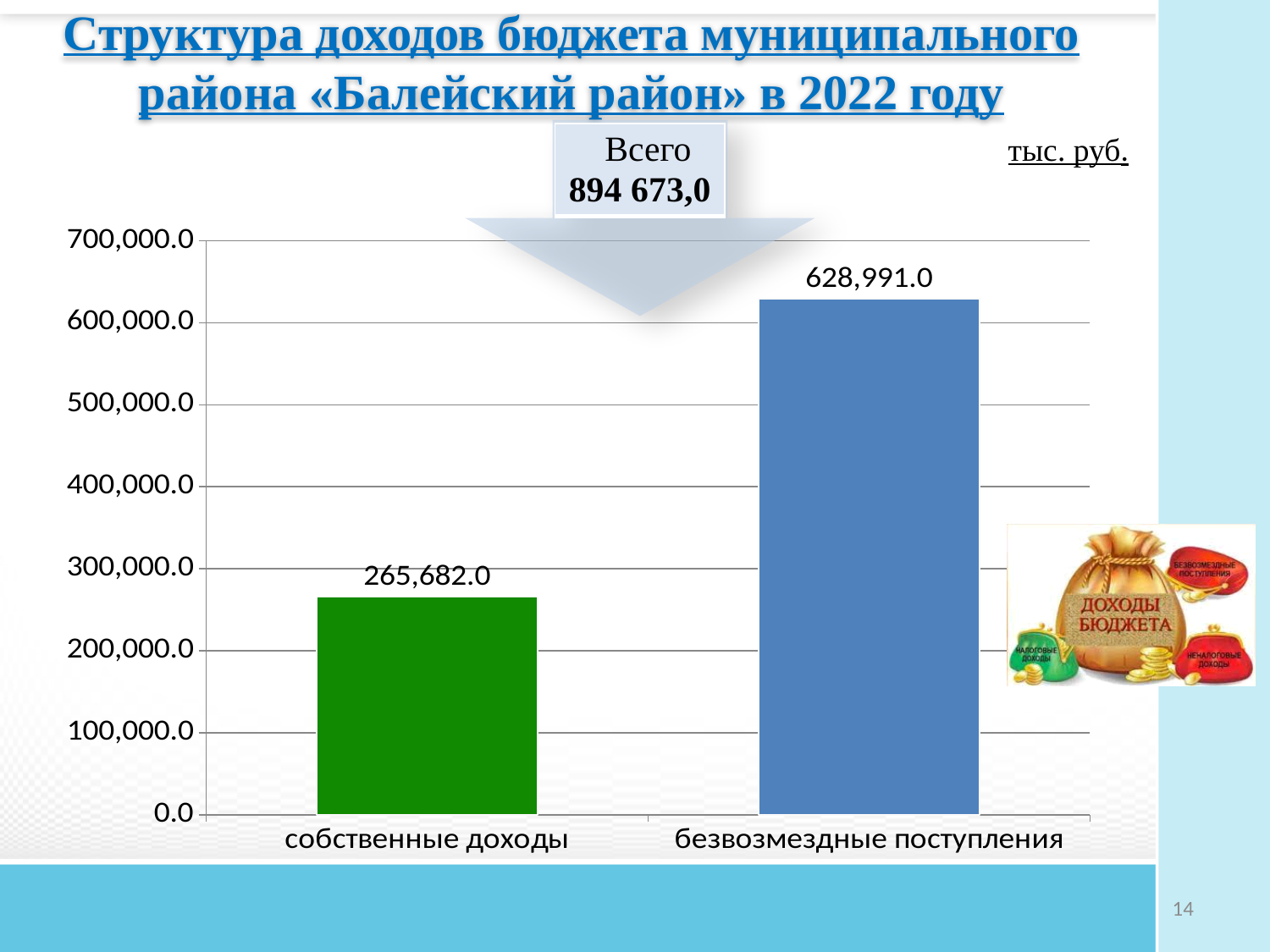
What unit is indicated for the chart values? тыс. руб. Is the value for безвозмездные поступления greater or less than 600,000.0? greater Which category has the highest value? безвозмездные поступления Is the value for собственные доходы greater or less than 300,000.0? less What kind of chart is shown on the slide? bar chart What is the value for безвозмездные поступления? 628,991.0 How many categories are shown on the chart? 2 Which is larger, собственные доходы or безвозмездные поступления? безвозмездные поступления What is the difference between безвозмездные поступления and собственные доходы? 363,309.0 What is the value for собственные доходы? 265,682.0 What total (Всего) is shown above the chart? 894 673,0 Which category has the lowest value? собственные доходы